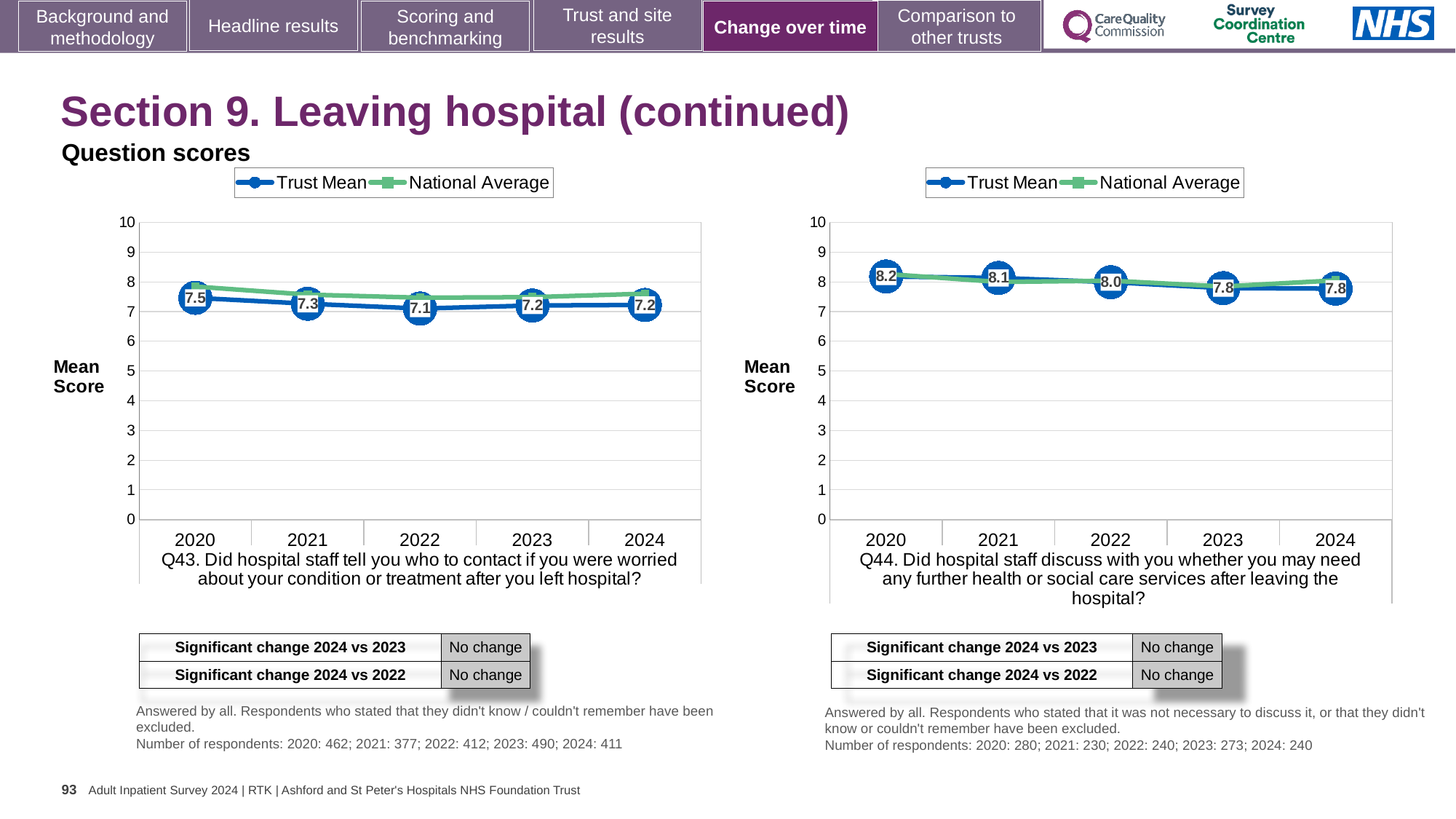
In the Q44 chart on the right, does the Trust Mean score generally rise or fall from 2020 to 2024? Fall In the Q44 chart on the right, which year has the highest Trust Mean score? 2020 How many years are plotted on the x axis of the Q44 chart on the right? 5 In the Q44 chart on the right, what is the difference between the Trust Mean scores for 2020 and 2024? 0.4 What type of chart is the Q44 chart on the right? Line chart In the Q44 chart on the right, what is the Trust Mean score for 2024? 7.8 In the Q43 chart on the left, is the Trust Mean score higher in 2020 or in 2021? 2020 In the Q43 chart on the left, what is the Trust Mean score for 2020? 7.5 In the Q43 chart on the left, which year has the lowest Trust Mean score? 2022 How many series does the legend of the Q43 chart on the left list? 2 In the Q43 chart on the left, is the National Average value for 2020 greater or less than 7? greater In the Q43 chart on the left, what is the Trust Mean score for 2022? 7.1